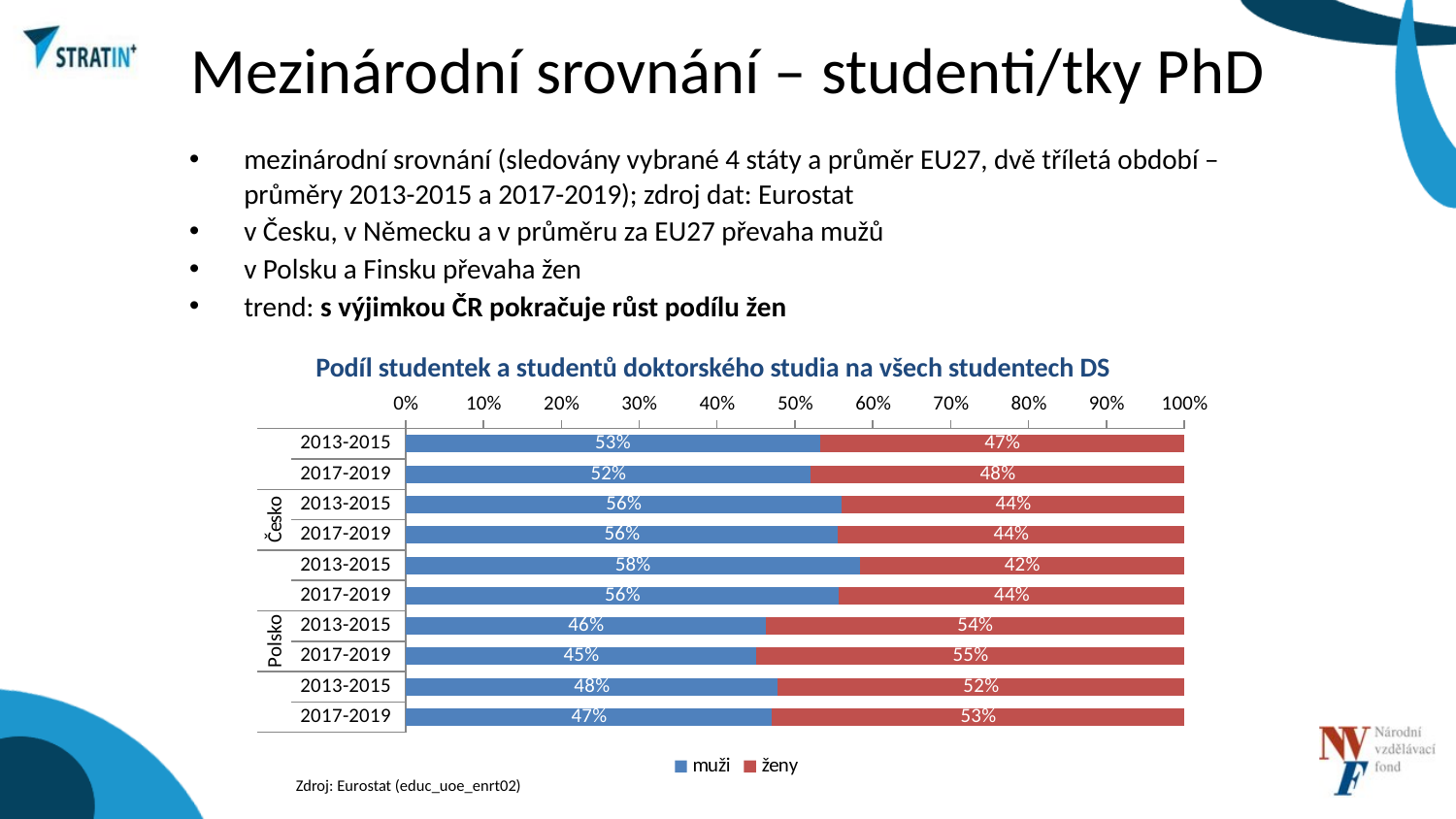
How many bars are plotted in the chart? 10 What is the share of ženy for Česko in 2017-2019? 44% What is the share of muži for Polsko in 2013-2015? 46% For Polsko in 2017-2019, which is larger, the share of muži or the share of ženy? ženy For Česko in 2017-2019, what is the difference between the share of muži and the share of ženy? 12 percentage points What kind of chart is shown on the slide? Stacked bar chart What is the share of ženy for Polsko in 2017-2019? 55% Is the share of muži for Polsko in 2013-2015 greater or less than 50%? less How many series does the chart legend list? 2 What is the title of the chart? Podíl studentek a studentů doktorského studia na všech studentech DS What are the two series named in the chart legend? muži and ženy What is the share of muži for Česko in 2013-2015? 56%